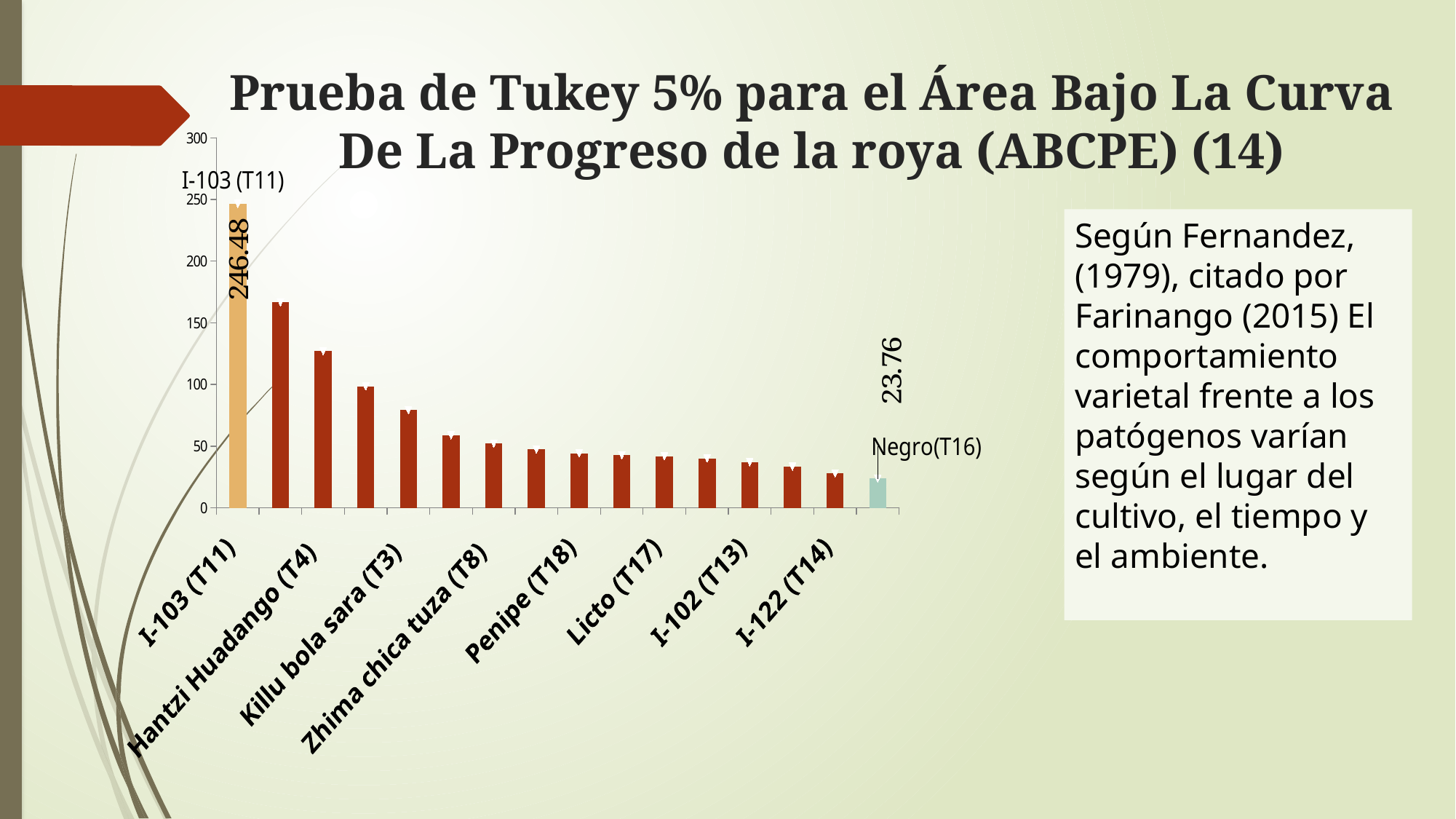
What is the title of the slide containing the chart? Prueba de Tukey 5% para el Área Bajo La Curva De La Progreso de la roya (ABCPE) (14) Which category has the lowest value? Negro(T16) Is the value for Zhima chica tuza (T8) greater or less than 100? less Which has a larger value, Hantzi Huadango (T4) or Killu bola sara (T3)? Hantzi Huadango (T4) Which category has the highest value? I-103 (T11) What kind of chart is shown on the slide? bar chart What is the value for Negro(T16)? 23.76 What is the value for I-103 (T11)? 246.48 Do the values rise or fall from left to right along the x axis? fall What is the difference between the values for I-103 (T11) and Negro(T16)? 222.72 Is the value for Hantzi Huadango (T4) greater or less than 150? less Is the value for Killu bola sara (T3) greater or less than 100? less